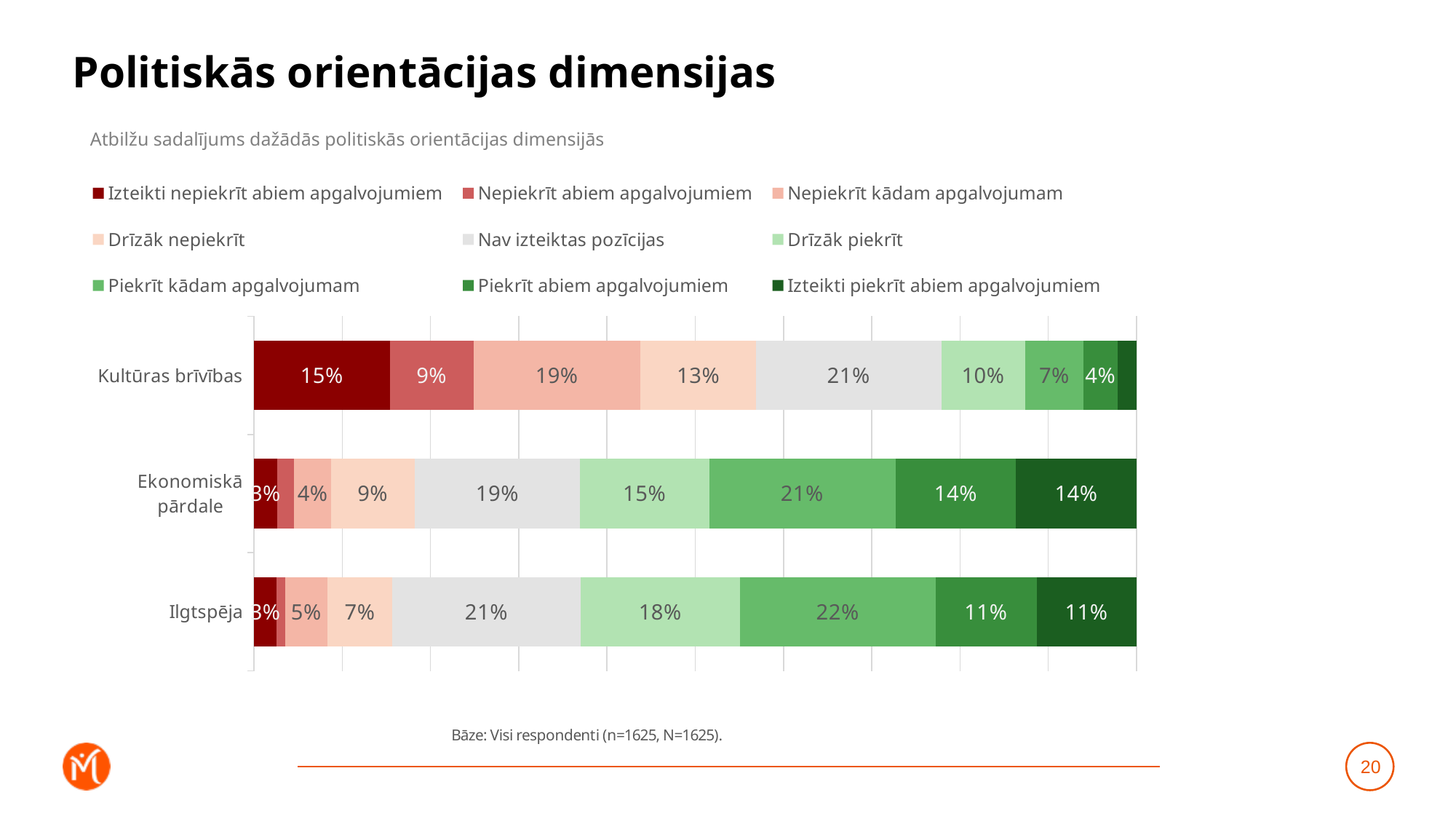
What is the value of "Drīzāk nepiekrīt" for Ekonomiskā pārdale? 9% What is the difference between the "Drīzāk piekrīt" values for Ilgtspēja and Ekonomiskā pārdale? 3 percentage points What is the value of "Izteikti nepiekrīt abiem apgalvojumiem" for Kultūras brīvības? 15% Which has a larger "Nepiekrīt kādam apgalvojumam" value, Kultūras brīvības or Ilgtspēja? Kultūras brīvības What colour represents "Nav izteiktas pozīcijas" in the chart? Grey What is the value of "Piekrīt abiem apgalvojumiem" for Ekonomiskā pārdale? 14% Which category has the highest "Izteikti piekrīt abiem apgalvojumiem" value? Ekonomiskā pārdale What is the value of "Piekrīt kādam apgalvojumam" for Ilgtspēja? 22% What kind of chart is shown on the slide? Stacked bar chart How many categories (dimensions) are plotted on the chart? 3 What is the value of "Nav izteiktas pozīcijas" for Kultūras brīvības? 21% How many series does the chart legend list? 9